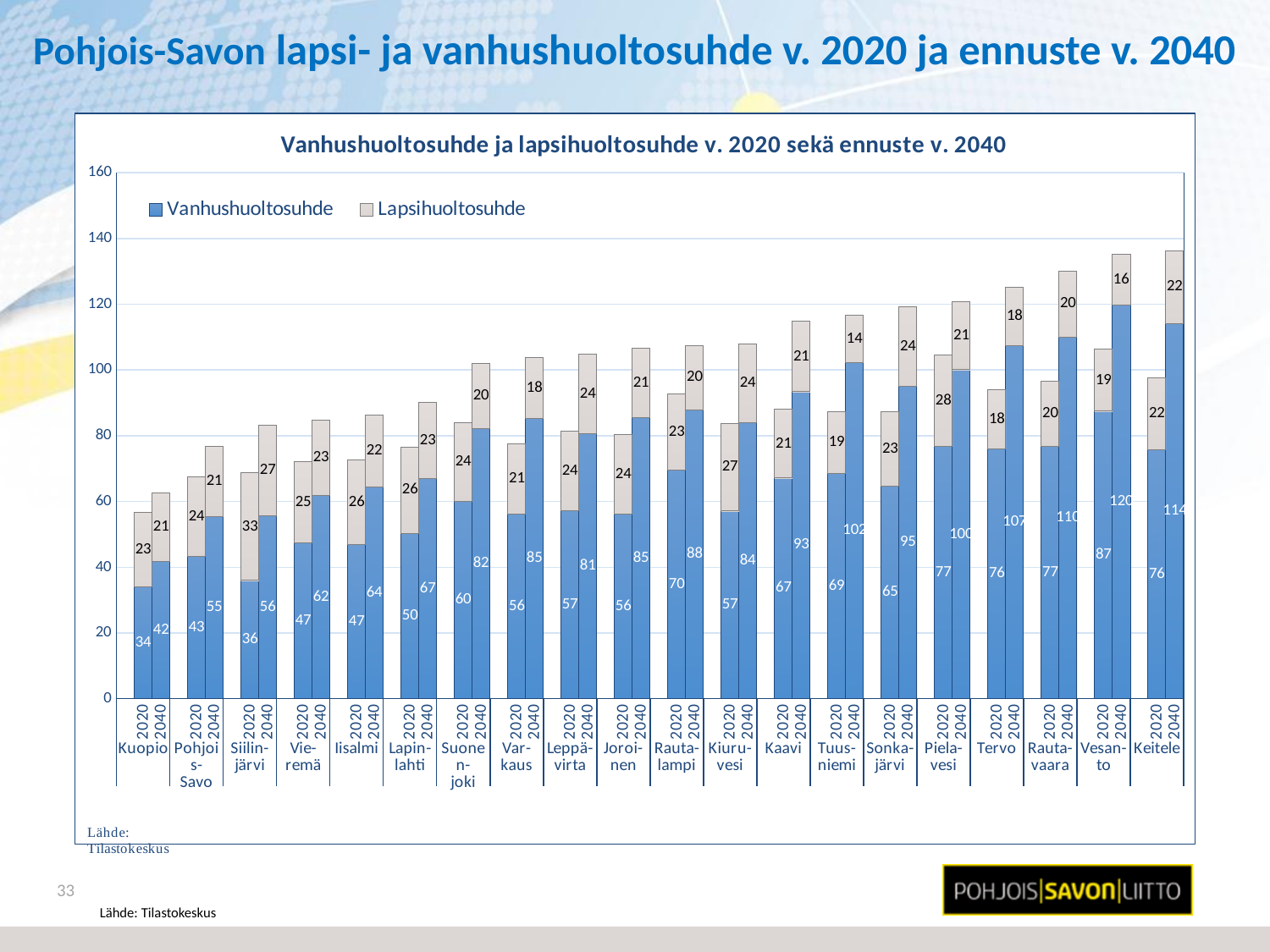
What is the Vanhushuoltosuhde value for Tuusniemi in 2040? 102 Which area has the lowest Vanhushuoltosuhde value in 2020? Kuopio Which area has the highest Vanhushuoltosuhde value in 2040? Vesanto Which has the larger Vanhushuoltosuhde value in 2020, Rautalampi or Kaavi? Rautalampi What is the total of the stacked bar for Kuopio in 2020? 57 How many series does the legend list? 2 What is the Vanhushuoltosuhde value for Kuopio in 2020? 34 What kind of chart is shown on the slide? Stacked bar chart What is the total of the stacked bar for Vesanto in 2040? 136 By how much does the Vanhushuoltosuhde for Tuusniemi increase from 2020 to 2040? 33 Which area has the lowest Lapsihuoltosuhde value in 2040? Tuusniemi What is the Lapsihuoltosuhde value for Siilinjärvi in 2020? 33